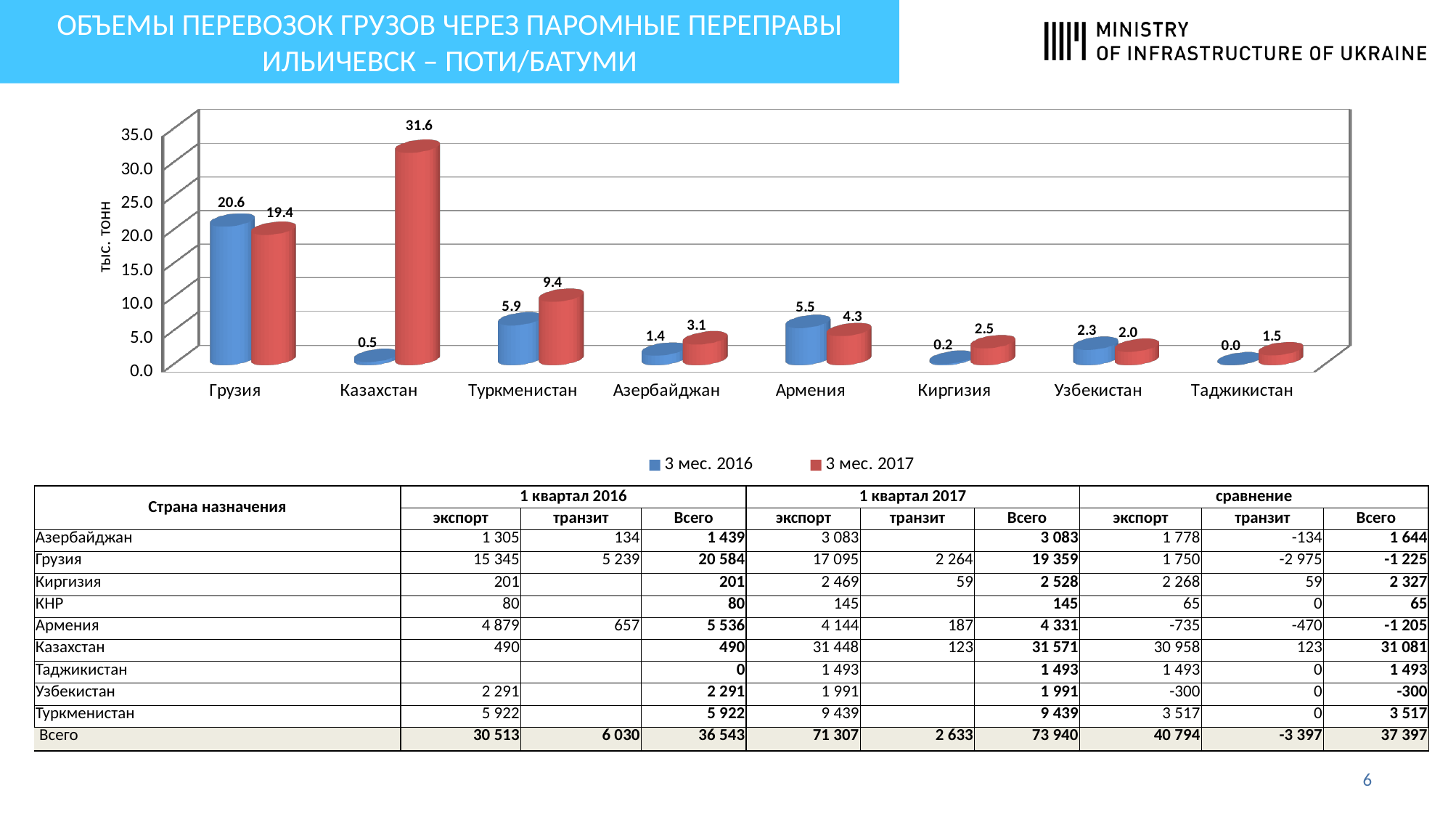
How many categories are shown on the x axis of the chart? 8 What kind of chart is shown on the slide? bar chart What is the value for Туркменистан in the 3 мес. 2017 series? 9.4 What is the value for Казахстан in the 3 мес. 2017 series? 31.6 Which is larger for Армения: the 3 мес. 2016 value or the 3 мес. 2017 value? 3 мес. 2016 What is the label of the chart's y axis? тыс. тонн What is the value for Киргизия in the 3 мес. 2016 series? 0.2 What is the value for Грузия in the 3 мес. 2016 series? 20.6 Which category has the highest value in the 3 мес. 2016 series? Грузия How many series does the chart legend list? 2 Which category has the lowest value in the 3 мес. 2017 series? Таджикистан What is the difference between the 3 мес. 2017 and 3 мес. 2016 values for Казахстан? 31.1